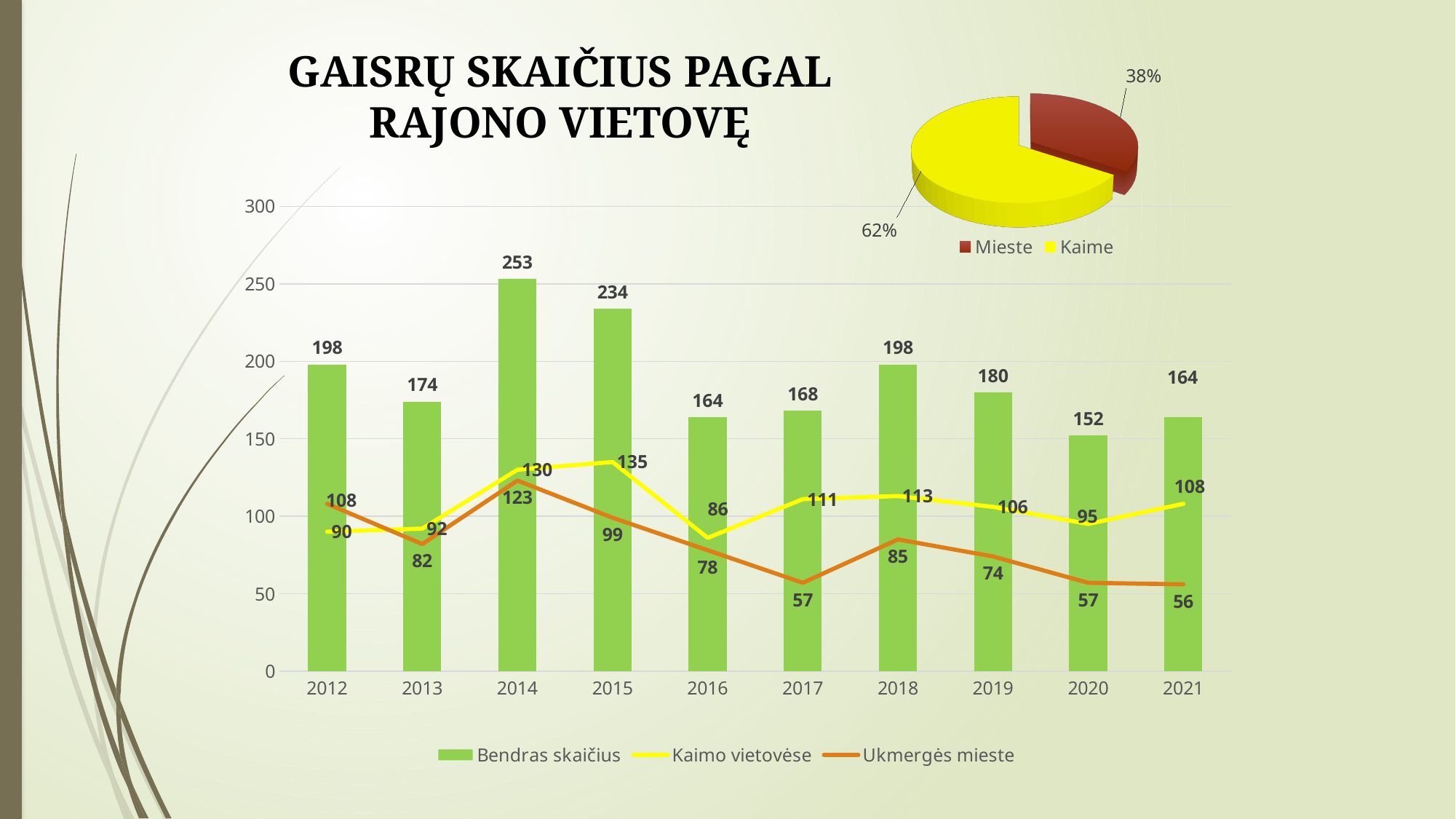
How many series does the legend of the main chart list? 3 In the main chart, which year has the highest Bendras skaičius? 2014 In the main chart, what is the value of Bendras skaičius for 2014? 253 In the main chart, how many years are shown on the x axis? 10 In the main chart, what is the value of Kaimo vietovėse for 2015? 135 In the main chart, does Ukmergės mieste rise or fall from 2018 to 2021? fall In the main chart, what is the difference between Bendras skaičius in 2014 and 2015? 19 What kind of chart is the one in the top right corner of the slide? pie chart In the main chart, which is larger in 2012: Kaimo vietovėse or Ukmergės mieste? Ukmergės mieste In the main chart, what is the value of Ukmergės mieste for 2017? 57 In the pie chart, what share does Kaime have? 62% In the main chart, which year has the lowest Bendras skaičius? 2020